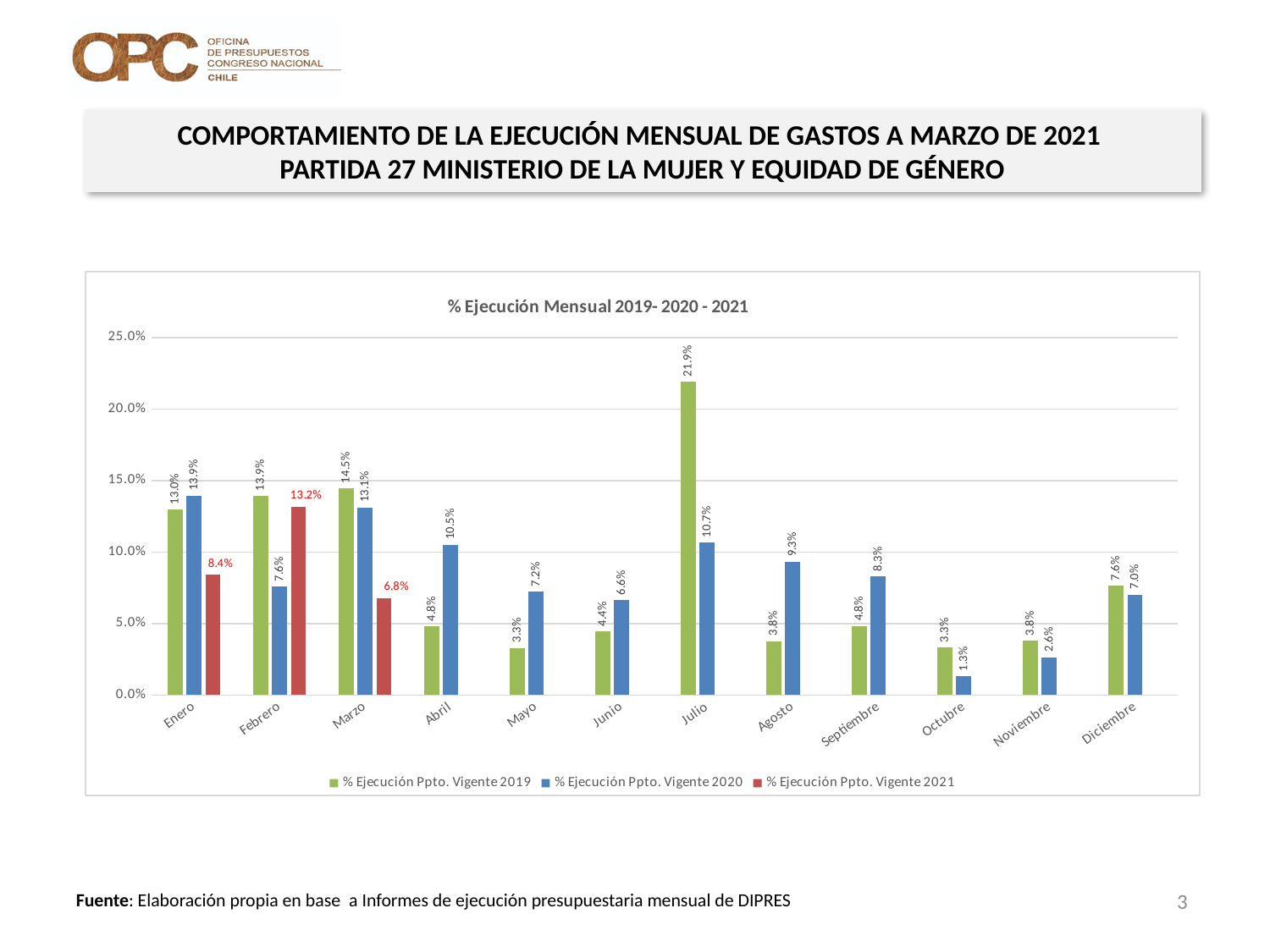
Is the value for % Ejecución Ppto. Vigente 2020 in Agosto greater or less than 5.0%? greater What is the title of the chart? % Ejecución Mensual 2019- 2020 - 2021 What is the value for % Ejecución Ppto. Vigente 2020 in Abril? 10.5% Which month has the highest value for % Ejecución Ppto. Vigente 2019? Julio How many series does the legend list? 3 How many months are shown on the x axis? 12 Which month has the lowest value for % Ejecución Ppto. Vigente 2020? Octubre What kind of chart is shown on the slide? Bar chart What is the value for % Ejecución Ppto. Vigente 2019 in Julio? 21.9% What is the difference between the 2019 and 2020 values in Julio? 11.2% What is the value for % Ejecución Ppto. Vigente 2021 in Febrero? 13.2% In Marzo, which series has the larger value: % Ejecución Ppto. Vigente 2019 or % Ejecución Ppto. Vigente 2020? % Ejecución Ppto. Vigente 2019